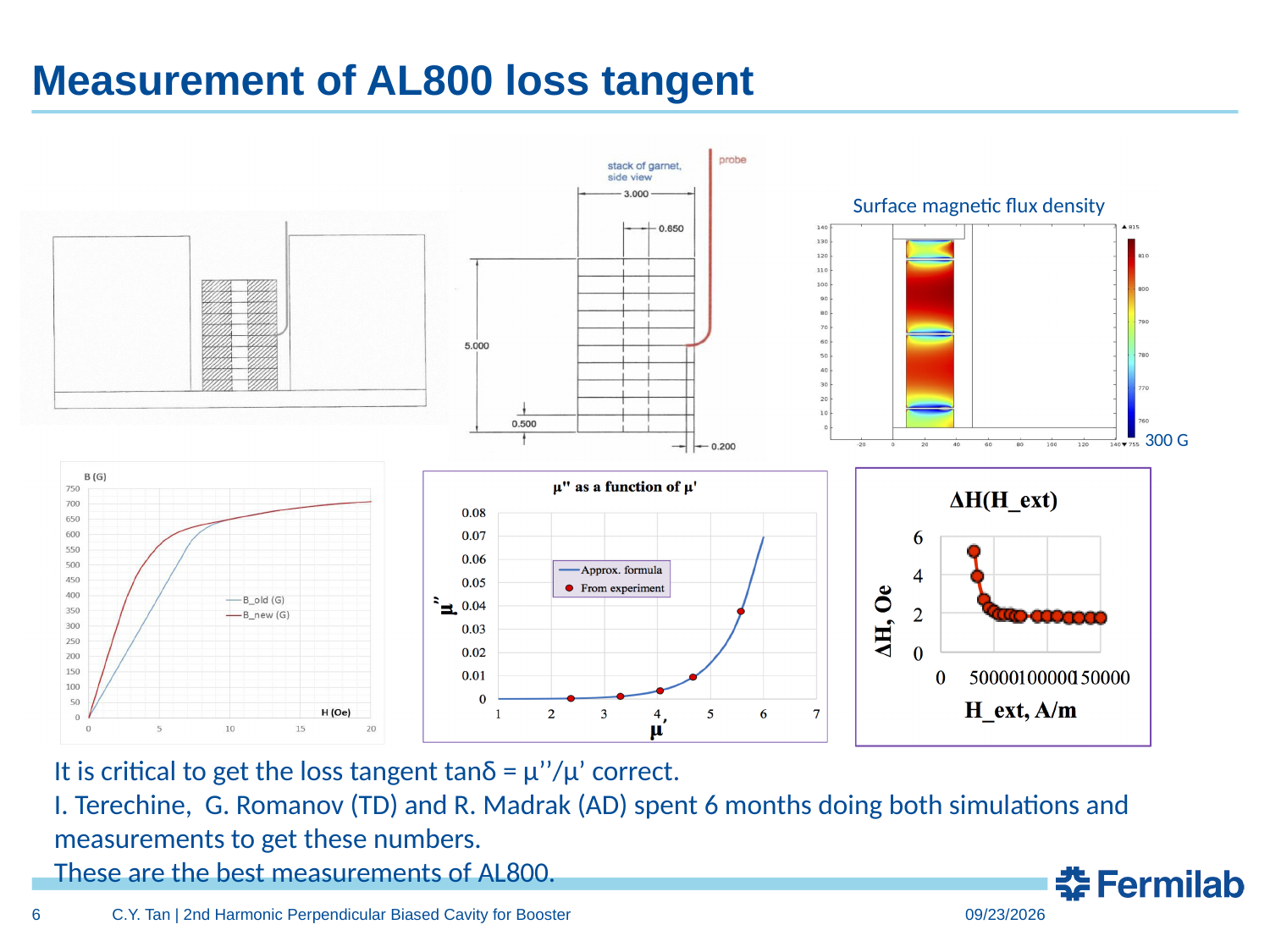
How many series does the legend of the chart titled "μ'' as a function of μ'" list? 2 In the B (G) versus H (Oe) chart, is the value of B_new (G) at H = 5 Oe greater or less than 500? greater In the chart titled "μ'' as a function of μ'", is the experimental μ'' value at the rightmost red point (near μ' = 5.6) greater or less than 0.03? greater In the chart titled "μ'' as a function of μ'", does μ'' rise or fall as μ' increases? rise What is the highest tick value shown on the vertical axis of the B (G) versus H (Oe) chart? 750 In the B (G) versus H (Oe) chart, which series is larger at H = 5 Oe, B_old (G) or B_new (G)? B_new (G) What kind of chart is the B (G) versus H (Oe) chart at the bottom left of the slide? line chart In the chart titled "ΔH(H_ext)", is the ΔH value of the first (leftmost) point greater or less than 4? greater In the chart titled "μ'' as a function of μ'", how many "From experiment" data points are plotted? 5 In the chart titled "ΔH(H_ext)", does ΔH rise or fall as H_ext increases? fall In the B (G) versus H (Oe) chart, do the B values rise or fall as H increases? rise How many series does the legend of the B (G) versus H (Oe) chart list? 2